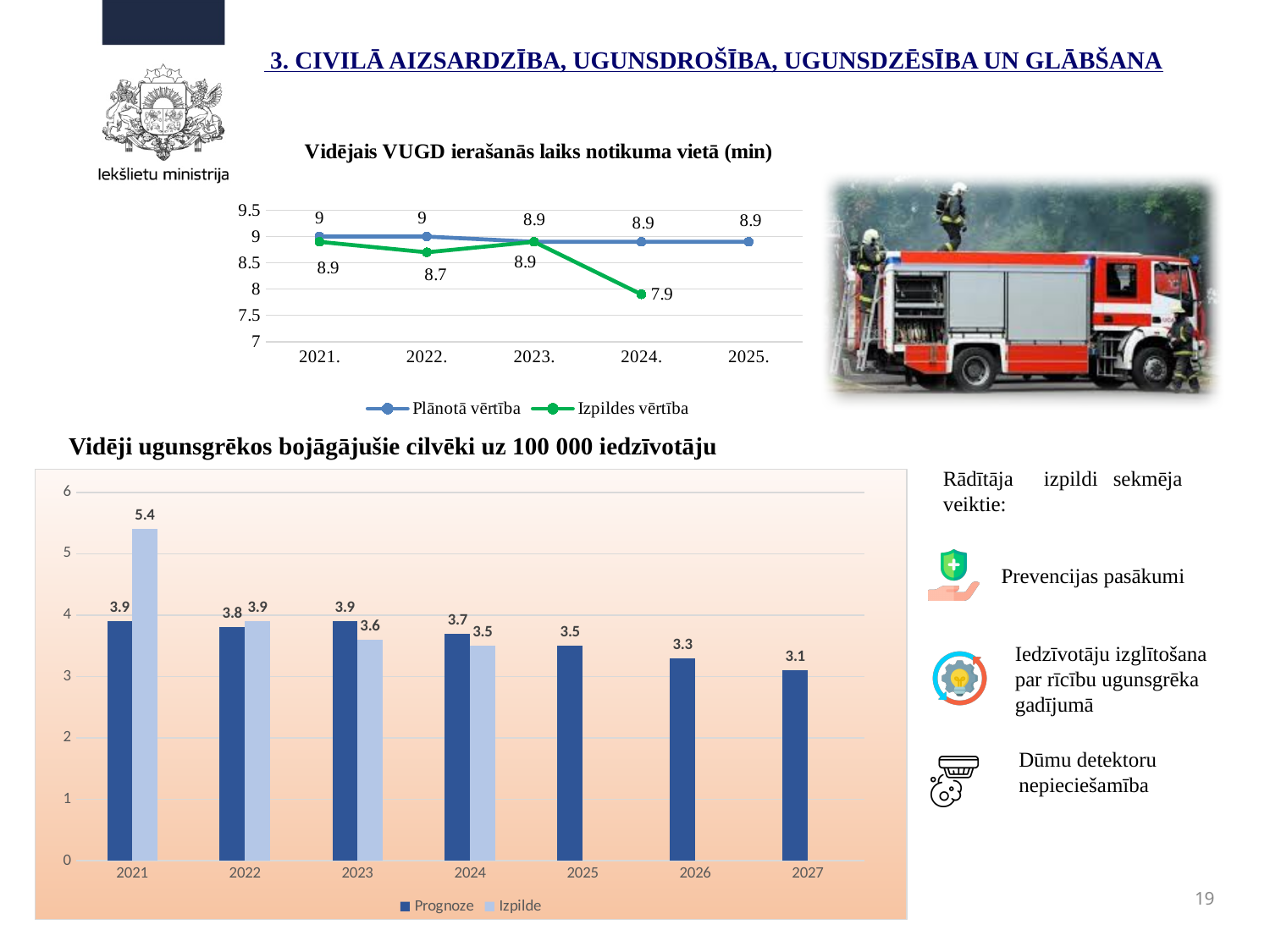
In the chart 'Vidējais VUGD ierašanās laiks notikuma vietā (min)', what is the Izpildes vērtība for 2024.? 7.9 In the chart 'Vidēji ugunsgrēkos bojāgājušie cilvēki uz 100 000 iedzīvotāju', do the Prognoze values rise or fall from 2023 to 2027? Fall In the chart 'Vidēji ugunsgrēkos bojāgājušie cilvēki uz 100 000 iedzīvotāju', what is the Prognoze value for 2027? 3.1 In the chart 'Vidēji ugunsgrēkos bojāgājušie cilvēki uz 100 000 iedzīvotāju', which year has the highest Izpilde value? 2021 In the chart 'Vidējais VUGD ierašanās laiks notikuma vietā (min)', what is the Plānotā vērtība for 2021.? 9 In the chart 'Vidējais VUGD ierašanās laiks notikuma vietā (min)', how many series does the legend list? 2 In the chart 'Vidēji ugunsgrēkos bojāgājušie cilvēki uz 100 000 iedzīvotāju', what is the difference between the Izpilde and Prognoze values in 2021? 1.5 In the chart 'Vidēji ugunsgrēkos bojāgājušie cilvēki uz 100 000 iedzīvotāju', what is the Izpilde value for 2021? 5.4 In the chart 'Vidējais VUGD ierašanās laiks notikuma vietā (min)', what is the difference between the Plānotā vērtība and the Izpildes vērtība in 2024.? 1 In the chart 'Vidēji ugunsgrēkos bojāgājušie cilvēki uz 100 000 iedzīvotāju', how many years are shown on the x axis? 7 In the chart 'Vidējais VUGD ierašanās laiks notikuma vietā (min)', which year has the lowest Izpildes vērtība? 2024. What kind of chart is 'Vidējais VUGD ierašanās laiks notikuma vietā (min)'? Line chart